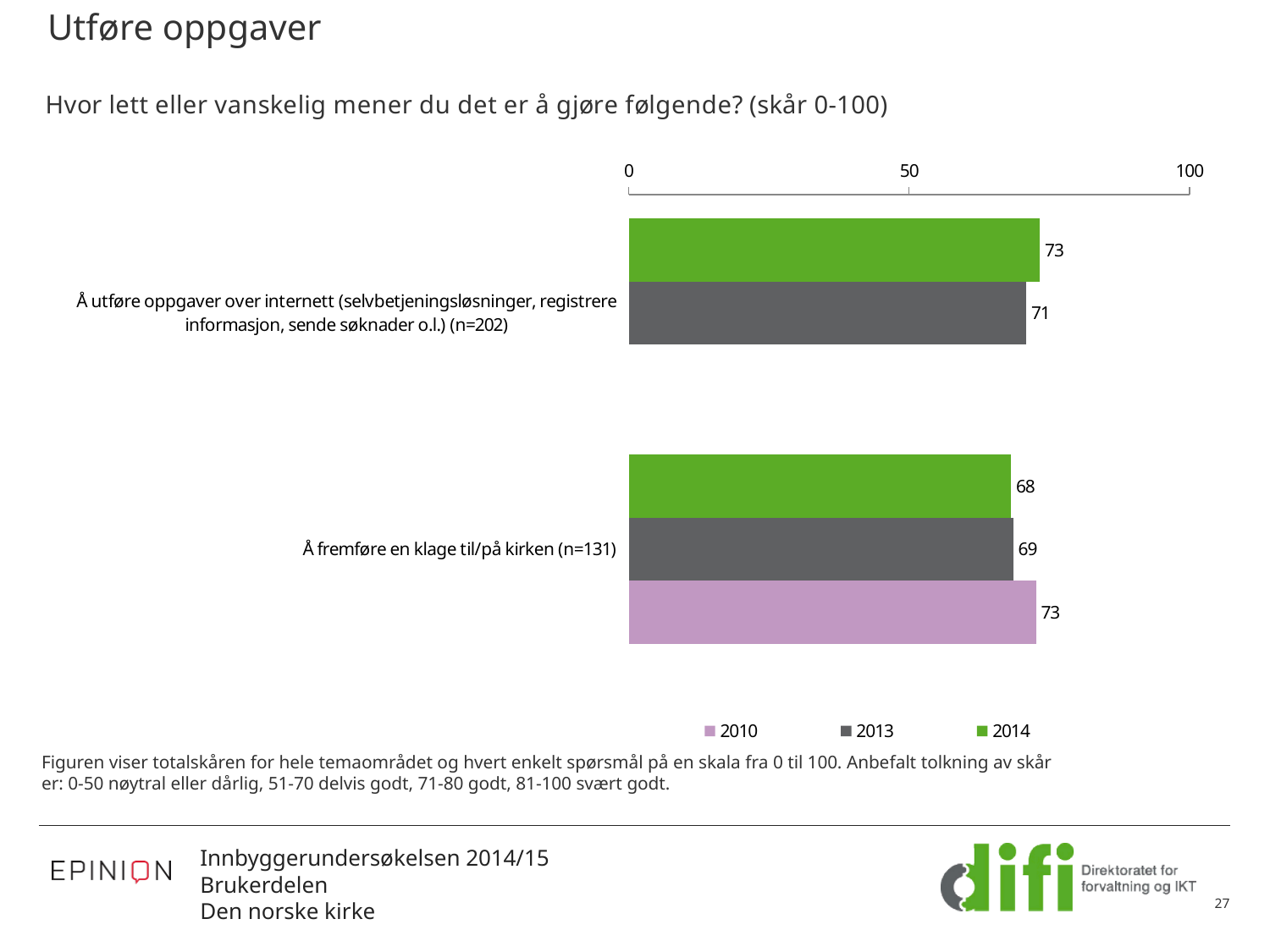
What is the 2014 score for "Å fremføre en klage til/på kirken (n=131)"? 68 How many series does the legend list? 3 What is the difference between the 2014 and 2013 scores for "Å utføre oppgaver over internett (selvbetjeningsløsninger, registrere informasjon, sende søknader o.l.) (n=202)"? 2 What is the 2010 score for "Å fremføre en klage til/på kirken (n=131)"? 73 What is the 2013 score for "Å fremføre en klage til/på kirken (n=131)"? 69 Which year has the lowest score for "Å fremføre en klage til/på kirken (n=131)"? 2014 What is the difference between the 2010 and 2014 scores for "Å fremføre en klage til/på kirken (n=131)"? 5 What is the 2013 score for "Å utføre oppgaver over internett (selvbetjeningsløsninger, registrere informasjon, sende søknader o.l.) (n=202)"? 71 Which year has the highest score for "Å fremføre en klage til/på kirken (n=131)"? 2010 What kind of chart is shown on the slide? Bar chart Which year is shown in green in the legend? 2014 What is the 2014 score for "Å utføre oppgaver over internett (selvbetjeningsløsninger, registrere informasjon, sende søknader o.l.) (n=202)"? 73